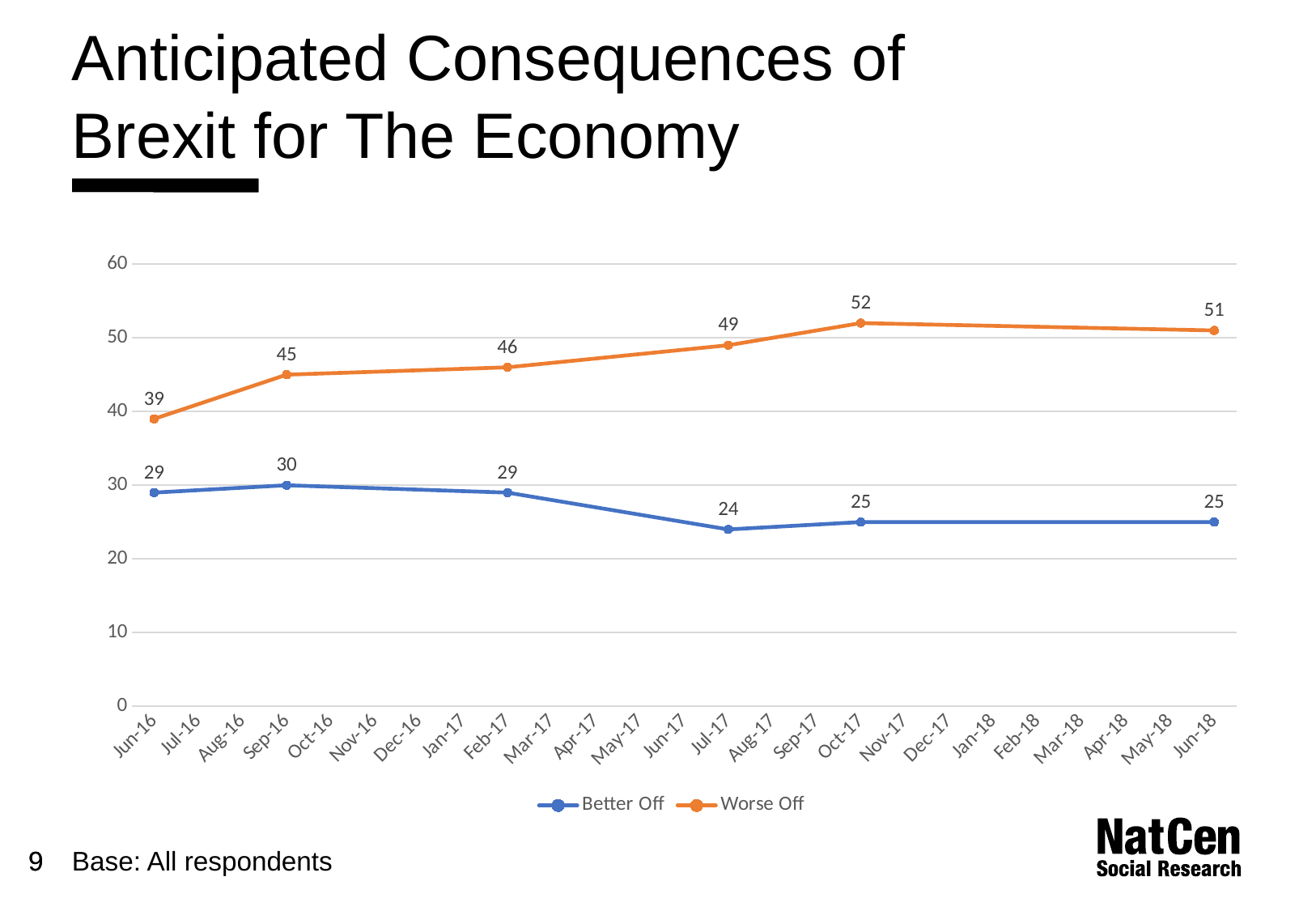
At which date does the Worse Off series reach its highest value? Oct-17 What is the value for Worse Off in Oct-17? 52 Which is larger in Sep-16, Better Off or Worse Off? Worse Off What kind of chart is shown on the slide? Line chart What is the value for Better Off in Jul-17? 24 How many series does the legend list? 2 What is the value for Worse Off in Jun-16? 39 Is the value for Worse Off in Feb-17 greater or less than 40? greater What is the difference between Worse Off and Better Off in Jun-18? 26 Does the Worse Off series generally rise or fall from Jun-16 to Oct-17? Rise What is the value for Better Off in Jun-18? 25 At which date does the Better Off series reach its lowest value? Jul-17